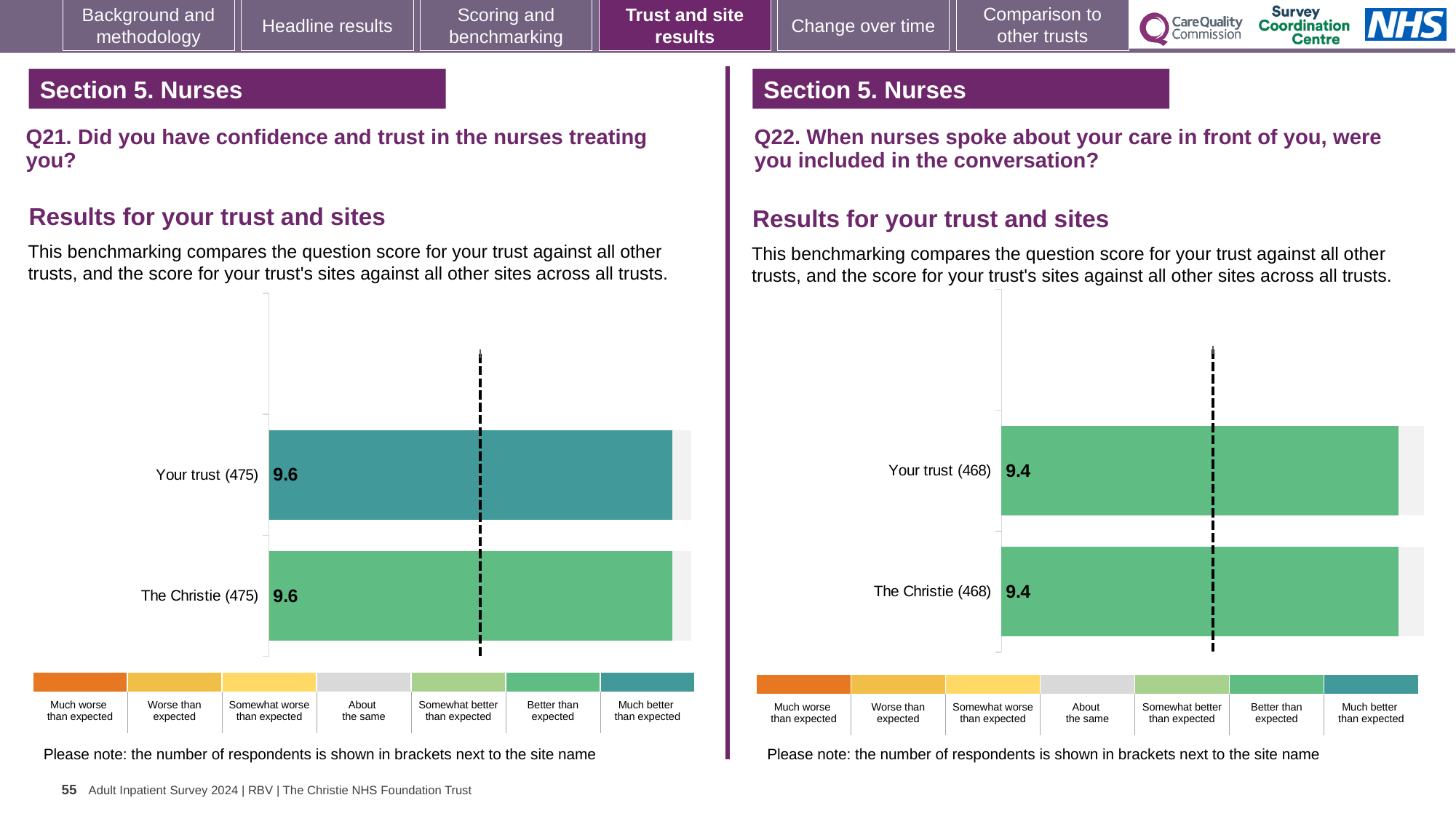
On the Q21 chart (left), what is the score for Your trust (475)? 9.6 How many bars are plotted on the Q22 chart (right)? 2 On the Q21 chart (left), which benchmark category does the colour of the Your trust bar correspond to in the legend? Much better than expected On the Q21 chart (left), what is the score for The Christie (475)? 9.6 Is the Your trust score on the Q22 chart (right) larger or smaller than the Your trust score on the Q21 chart (left)? Smaller On the Q22 chart (right), what is the difference between the Your trust score and The Christie score? 0.0 What kind of chart is used on the Q22 chart (right)? Bar chart On the Q21 chart (left), how many respondents are shown in brackets for The Christie? 475 On the Q22 chart (right), what is the score for Your trust (468)? 9.4 On the Q21 chart (left), what is the difference between the Your trust score and The Christie score? 0.0 On the Q22 chart (right), what is the score for The Christie (468)? 9.4 How many bars are plotted on the Q21 chart (left)? 2